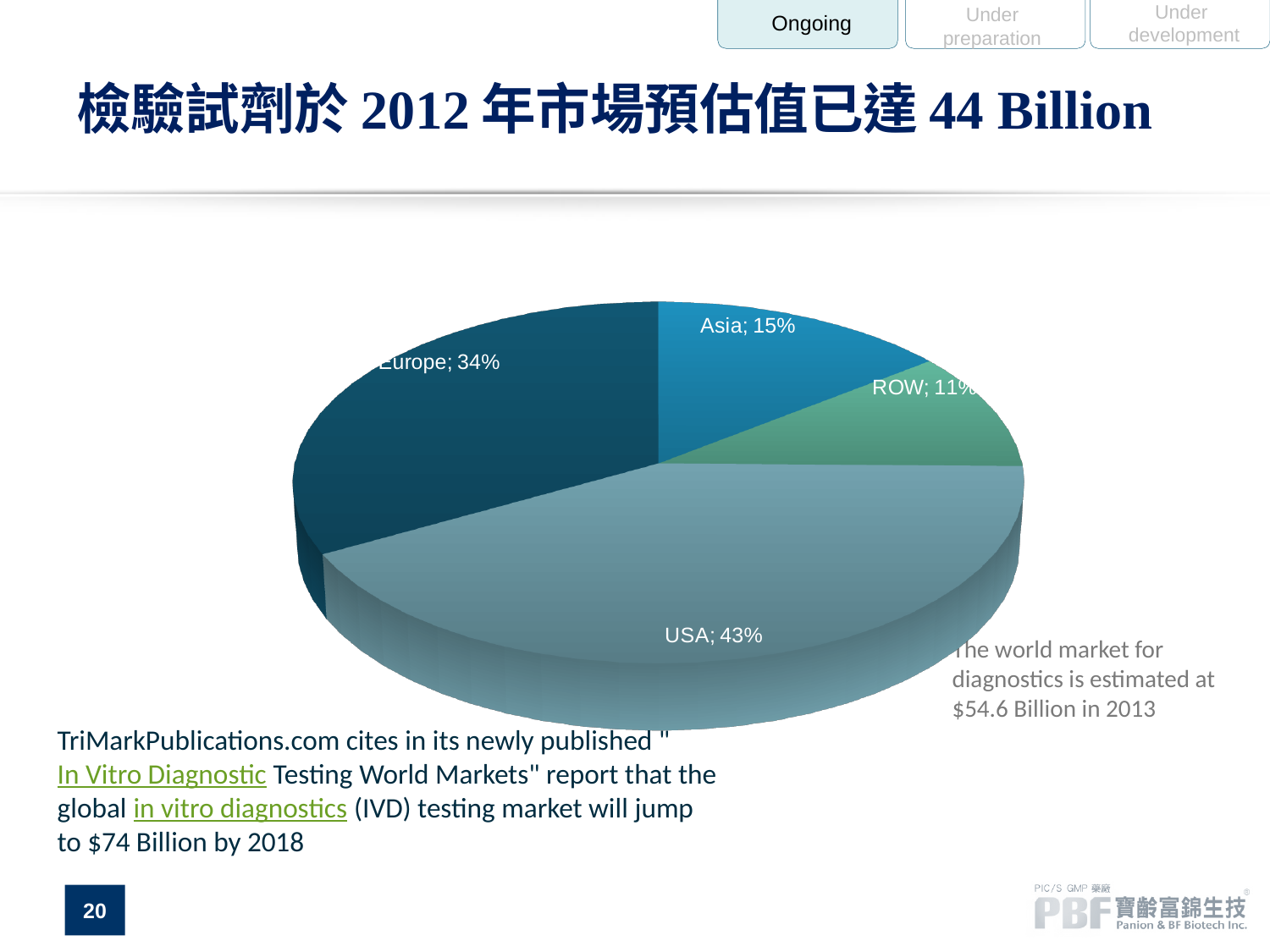
What share of the pie does Asia hold? 15% Which region's slice is labelled at the bottom of the pie chart? USA What is the difference in percentage points between the Europe and Asia slices? 19 What share of the pie does ROW hold? 11% Which region has the largest slice of the pie? USA What is the difference in percentage points between the USA and Europe slices? 9 How many slices does the pie chart have? 4 Which is larger, the Asia slice or the ROW slice? Asia What kind of chart is shown on the slide? pie chart Which region has the smallest slice of the pie? ROW What share of the pie does Europe hold? 34%